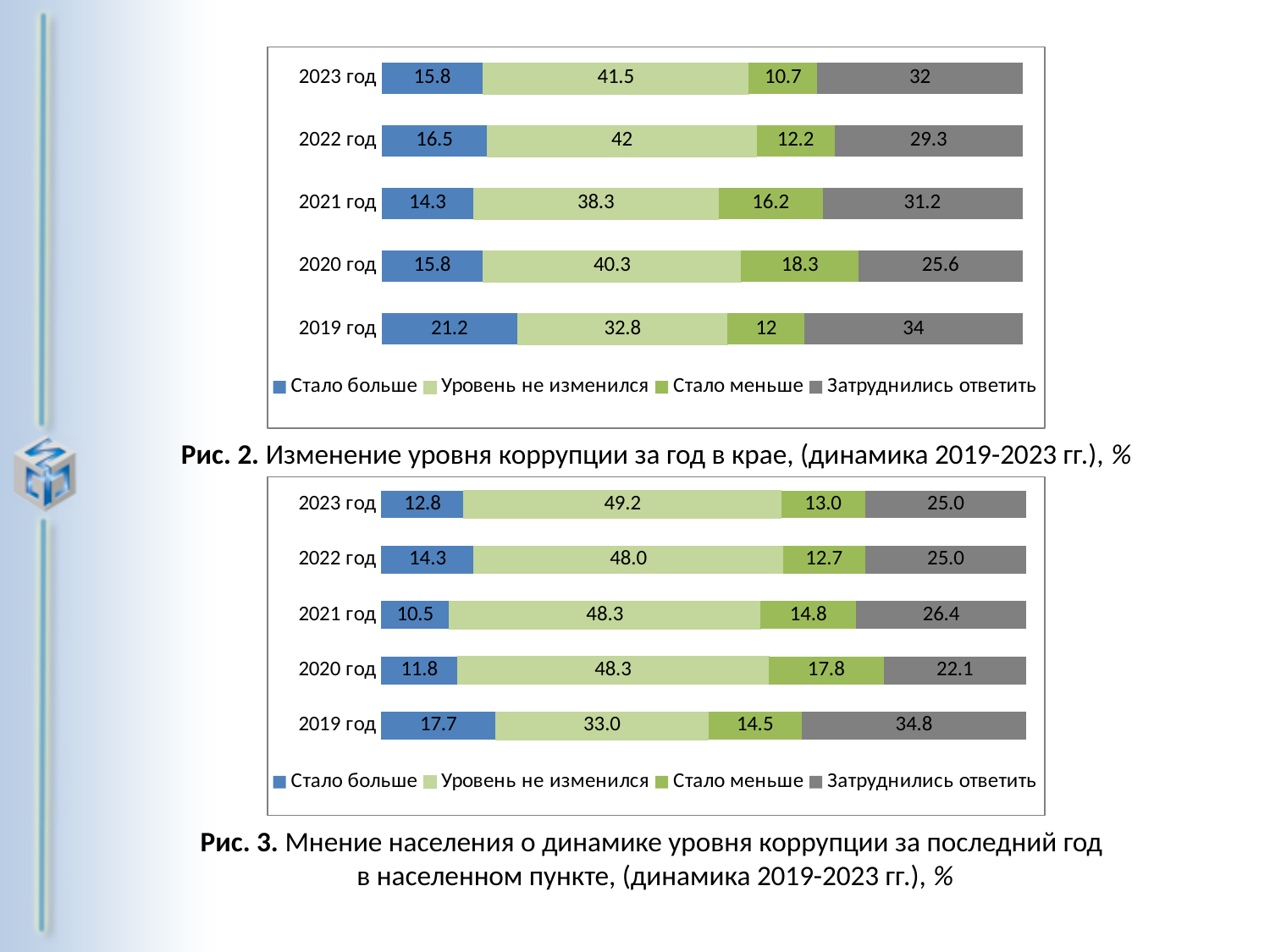
In the bottom chart (Рис. 3), is the "Затруднились ответить" value larger in 2019 год or in 2020 год? 2019 год In the top chart (Рис. 2), which year has the lowest value for "Уровень не изменился"? 2019 год In the bottom chart (Рис. 3), what is the value for "Уровень не изменился" in 2023 год? 49.2 What kind of chart is the bottom chart (Рис. 3)? Stacked bar chart In the top chart (Рис. 2), what is the difference between the "Уровень не изменился" values for 2022 год and 2019 год? 9.2 In the bottom chart (Рис. 3), what is the value for "Стало меньше" in 2020 год? 17.8 In the bottom chart (Рис. 3), which year has the lowest value for "Стало больше"? 2021 год In the top chart (Рис. 2), which year has the highest value for "Стало меньше"? 2020 год In the top chart (Рис. 2), what is the value for "Стало больше" in 2019 год? 21.2 In the top chart (Рис. 2), how many series does the legend list? 4 In the bottom chart (Рис. 3), what is the total of the stacked bar for 2019 год? 100.0 In the top chart (Рис. 2), what is the value for "Затруднились ответить" in 2022 год? 29.3